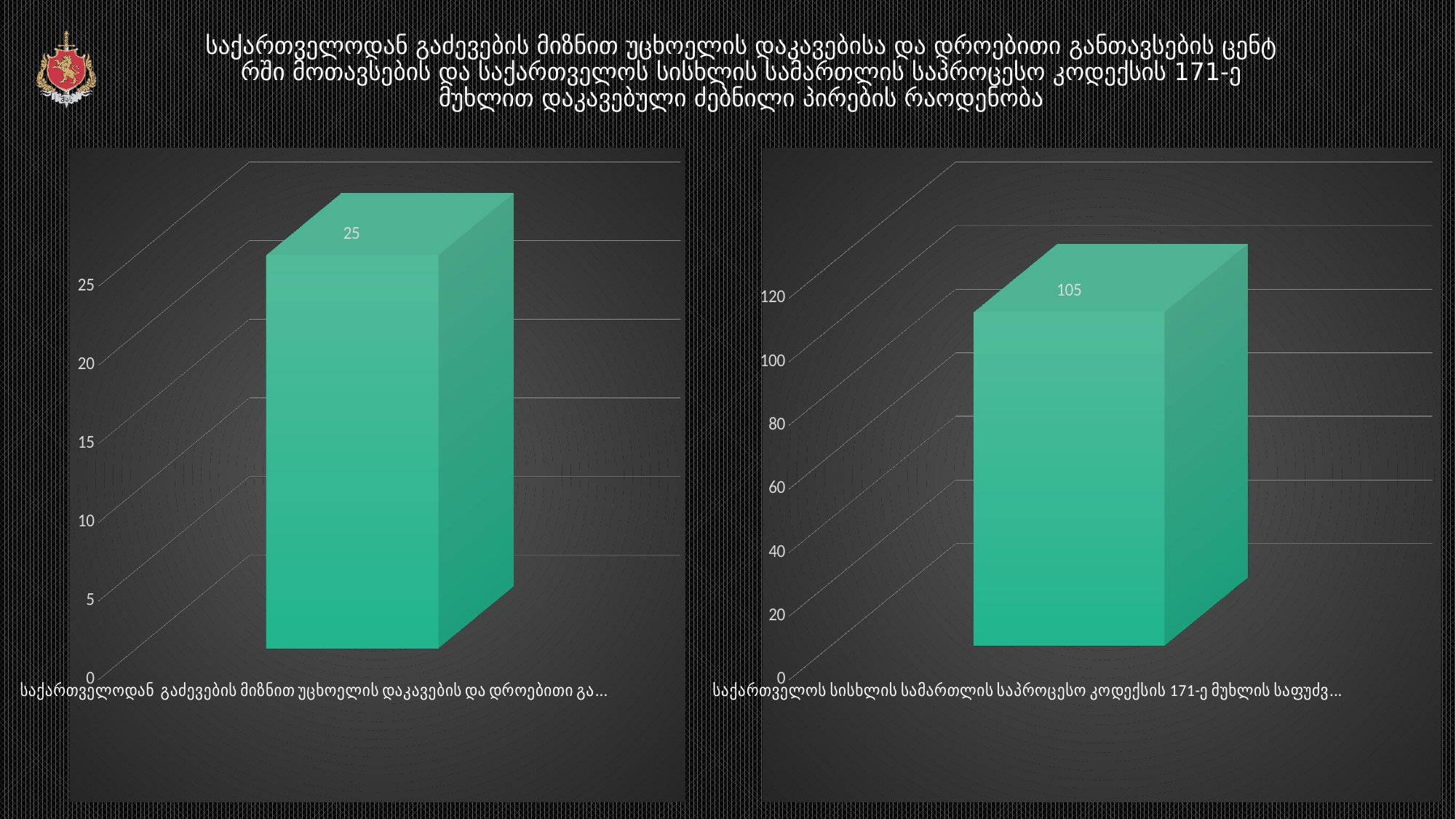
On the right chart, what is the highest value labelled on the vertical axis? 120 On the left chart, is the value of the bar greater or less than 20? greater What is the difference between the value on the right chart and the value on the left chart? 80 On the right chart, is the value of the bar greater or less than 100? greater How many bars are plotted on the left chart? 1 What kind of chart is the left chart? bar chart On the left chart, what value is printed on the bar? 25 How many bars are plotted on the right chart? 1 What kind of chart is the right chart? bar chart Which chart shows the larger value, the left chart or the right chart? the right chart On the right chart, what value is printed on the bar? 105 What colour are the bars on both charts? green